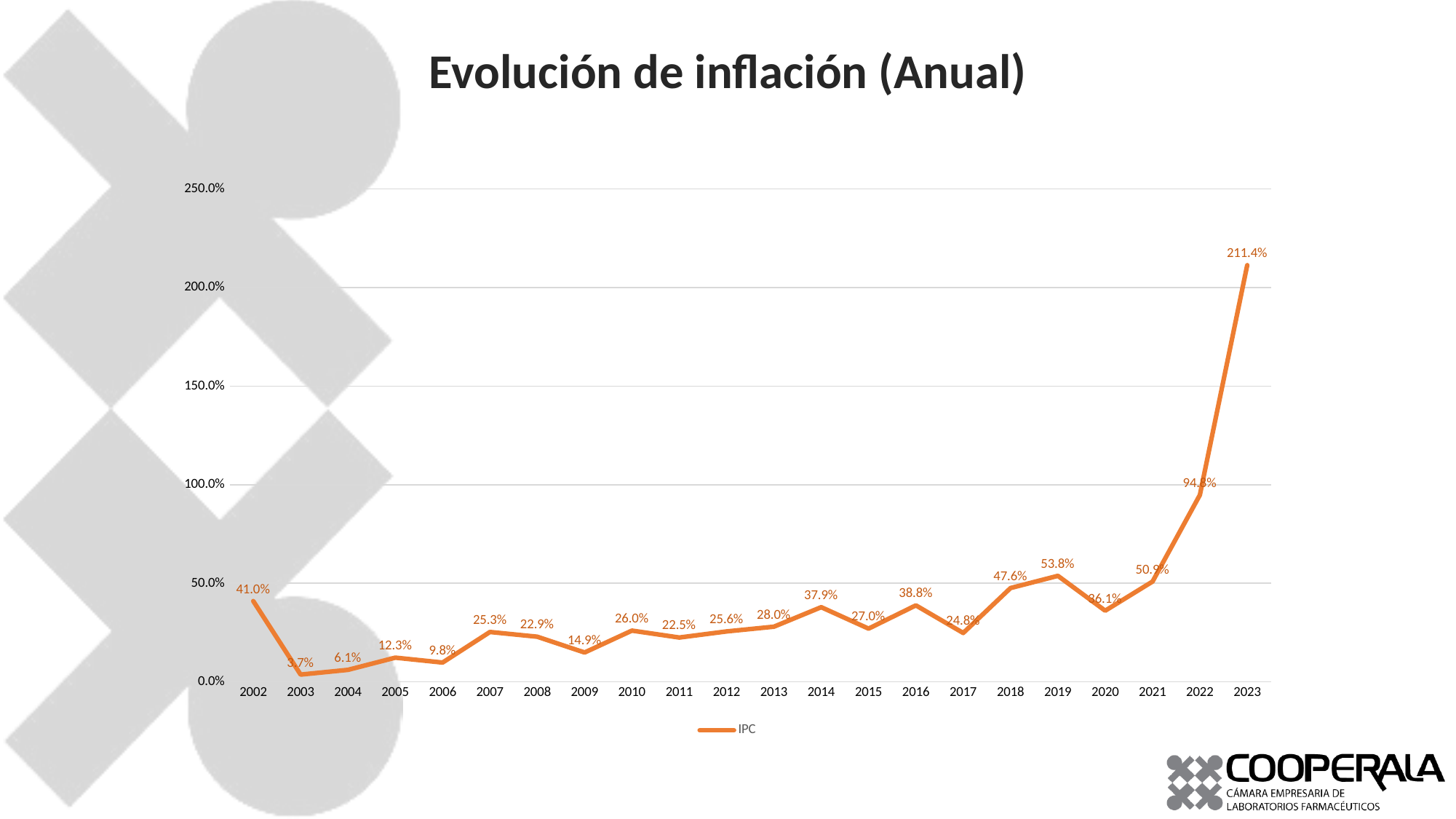
Which year has the lowest IPC value? 2003 Which year has the highest IPC value? 2023 What is the IPC value for 2019? 53.8% What kind of chart is shown on the slide? line chart Is the IPC value for 2022 greater or less than 100.0%? less How many series does the legend list? 1 What is the difference between the IPC values for 2023 and 2021? 160.5% How many years are plotted on the x axis? 22 What is the difference between the IPC values for 2019 and 2018? 6.2% What is the IPC value for 2023? 211.4% What is the IPC value for 2010? 26.0% Which year has a higher IPC value, 2014 or 2016? 2016